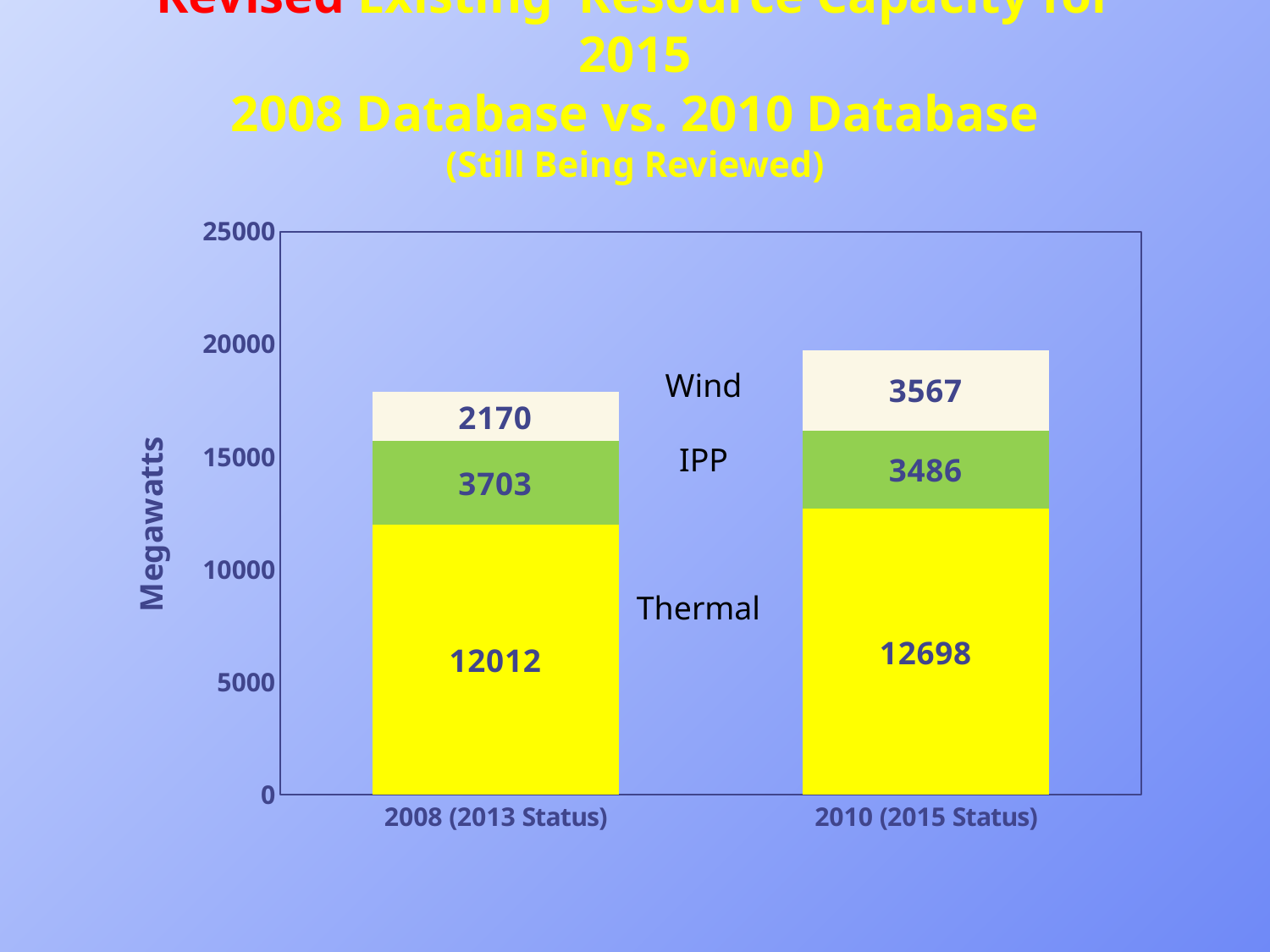
What is the Thermal value for 2008 (2013 Status)? 12012 What is the Wind value for 2010 (2015 Status)? 3567 What is the IPP value for 2010 (2015 Status)? 3486 How many categories are shown on the x axis? 2 What is the difference between the Thermal values for 2010 (2015 Status) and 2008 (2013 Status)? 686 Which has the larger IPP value, 2008 (2013 Status) or 2010 (2015 Status)? 2008 (2013 Status) What is the total of the stacked bar for 2008 (2013 Status)? 17885 What kind of chart is shown on the slide? Stacked bar chart What is the total of the stacked bar for 2010 (2015 Status)? 19751 What is the label on the vertical axis? Megawatts What is the Wind value for 2008 (2013 Status)? 2170 What is the difference between the Wind values for 2010 (2015 Status) and 2008 (2013 Status)? 1397